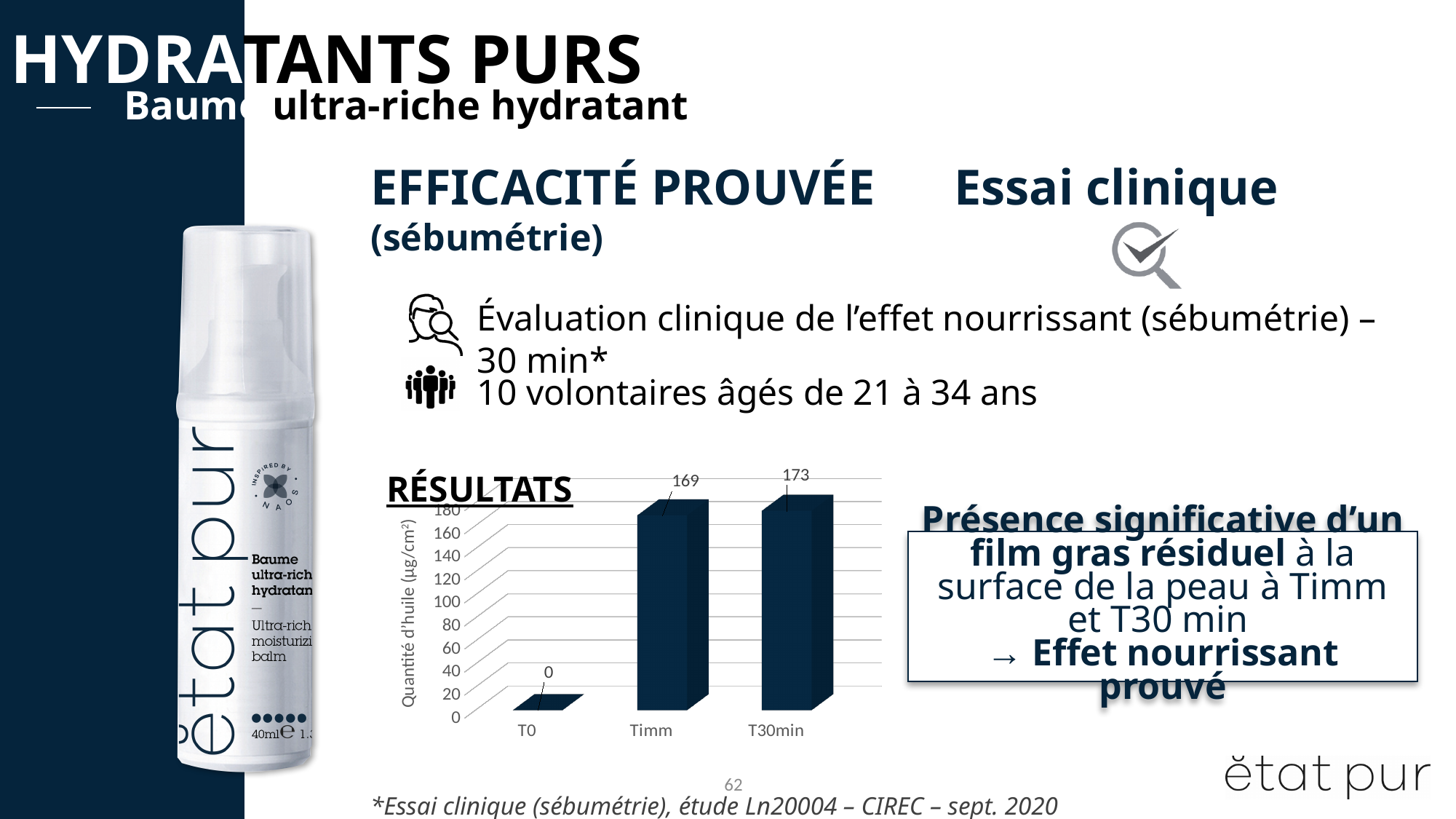
Is the value for Timm greater or less than 160? greater What kind of chart is shown? bar chart Which category has the lowest value? T0 What is the value for T0? 0 What is the value for Timm? 169 What is the value for T30min? 173 What is the difference between the values for Timm and T0? 169 Which category has the highest value? T30min Do the values rise or fall from T0 to T30min? rise What is the difference between the values for T30min and Timm? 4 What is the label of the vertical axis? Quantité d'huile (µg/cm²) How many categories are shown on the x axis? 3